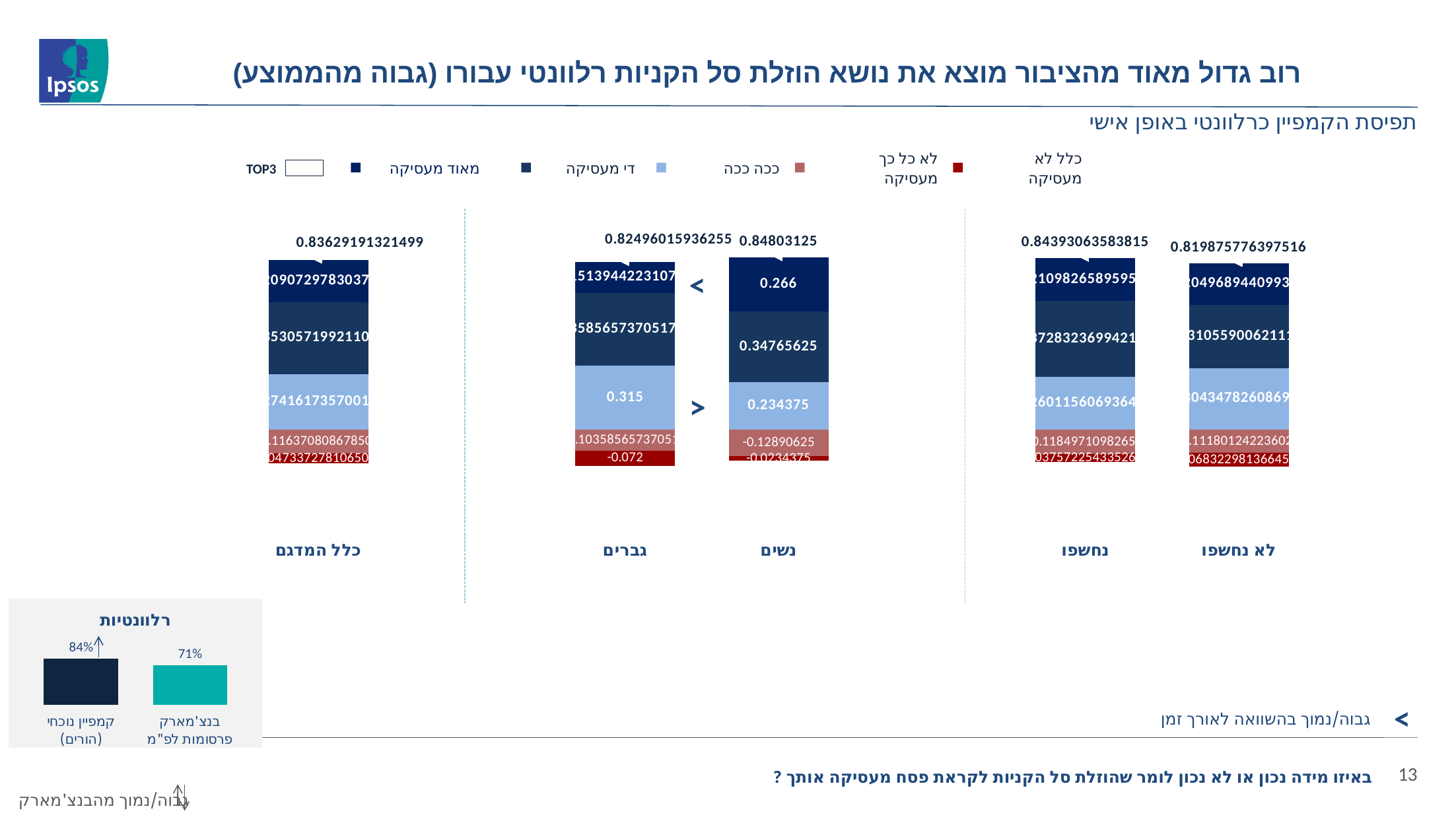
In the main stacked bar chart, which category has the lowest TOP3 value? לא נחשפו In the small רלוונטיות chart at the bottom left, which is larger: קמפיין נוכחי (הורים) or בנצ'מארק פרסומות לפ"מ? קמפיין נוכחי (הורים) In the small רלוונטיות chart at the bottom left, what is the value for קמפיין נוכחי (הורים)? 84% In the main stacked bar chart, what is the difference between the די מעסיקה segment for גברים and for נשים? 0.080625 In the main stacked bar chart, what is the TOP3 value printed above the bar for נשים? 0.84803125 In the main stacked bar chart, what is the value of the די מעסיקה segment for גברים? 0.315 In the main stacked bar chart, what is the TOP3 value printed above the bar for גברים? 0.82496015936255 In the main stacked bar chart, what is the value of the כלל לא מעסיקה segment for גברים? -0.072 In the main stacked bar chart, what is the value of the מאוד מעסיקה segment for נשים? 0.266 In the main stacked bar chart, how many categories (bars) are shown along the x axis? 5 In the main stacked bar chart, which category has the highest TOP3 value? נשים What kind of chart is the main chart in the middle of the slide? bar chart